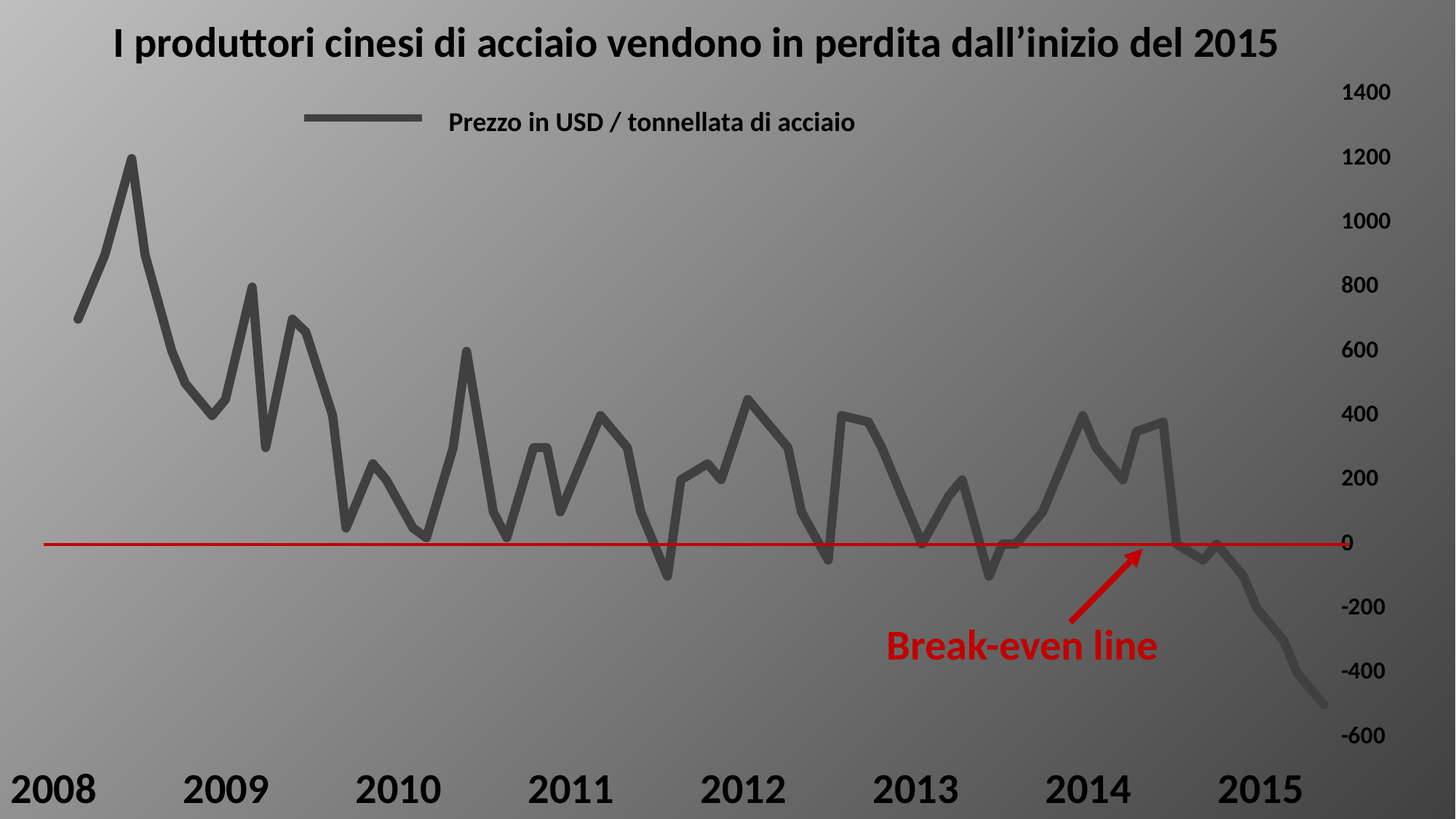
Is the final value at the end of 2015 greater or less than -400? less In which year does the line reach its lowest point? 2015 How many series does the legend list? 1 What is the title of the chart? I produttori cinesi di acciaio vendono in perdita dall'inizio del 2015 Is the peak value in 2008 larger or smaller than the peak value in 2014? larger In which year does the line reach its highest point? 2008 Overall, do the values rise or fall from 2008 to 2015? fall Is the peak value in 2008 greater or less than 1000? greater What is the legend entry for the plotted series? Prezzo in USD / tonnellata di acciaio How many year labels are shown on the x axis? 8 What kind of chart is shown on the slide? line chart Is the value at the end of 2015 greater or less than 0? less